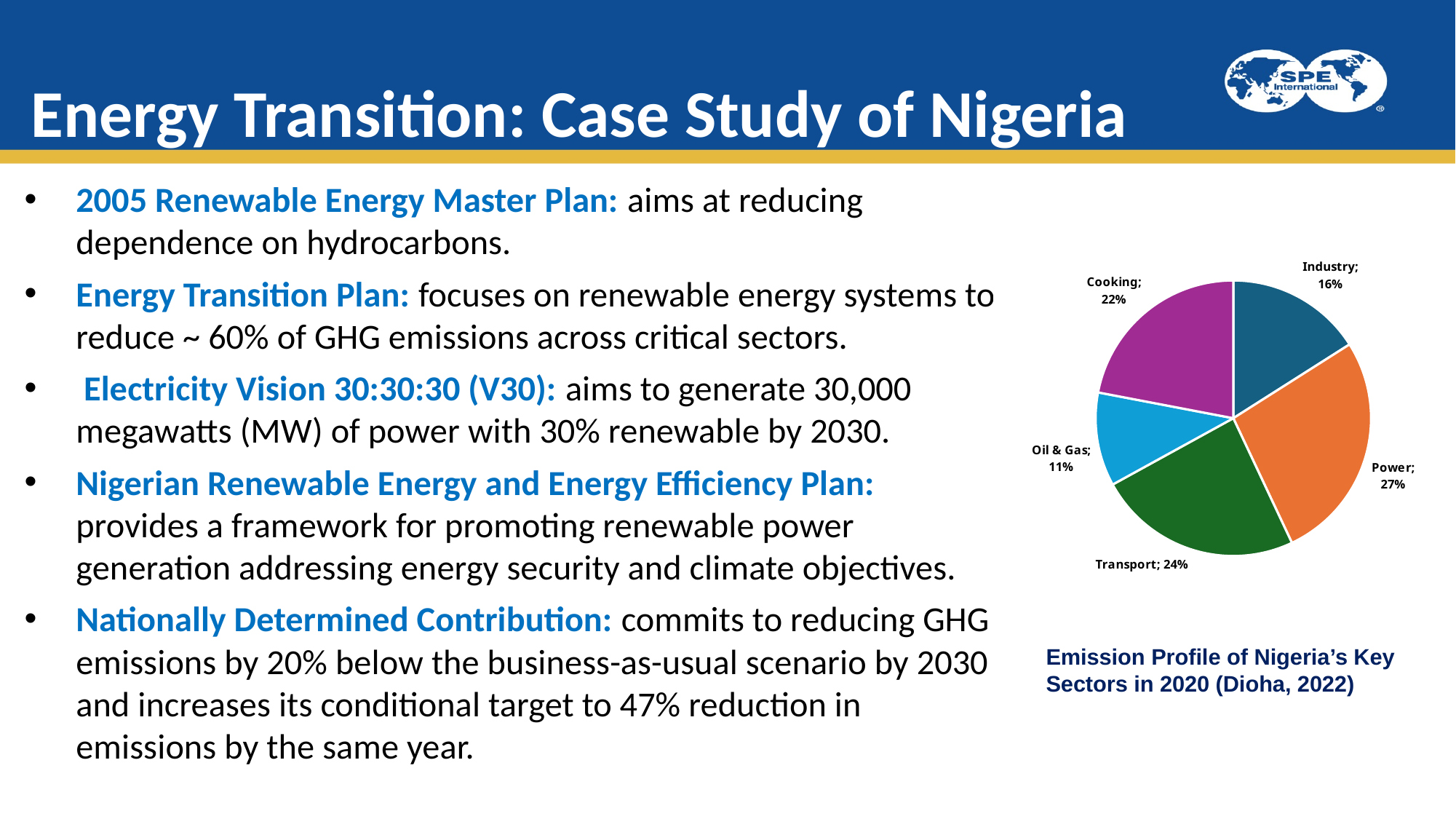
What share of emissions does the Power sector account for in the pie chart? 27% Which has a larger share, Transport or Cooking? Transport What share of emissions does the Cooking sector account for in the pie chart? 22% What is the title of the chart on the slide? Emission Profile of Nigeria's Key Sectors in 2020 (Dioha, 2022) How many sectors are shown in the pie chart? 5 What share of emissions does the Transport sector account for in the pie chart? 24% What share of emissions does the Oil & Gas sector account for in the pie chart? 11% Which sector has the largest share in the pie chart? Power What is the difference in percentage points between the Power and Industry shares? 11 Which sector has the smallest share in the pie chart? Oil & Gas What kind of chart is shown on the slide? Pie chart What colour is the Transport slice in the pie chart? Green